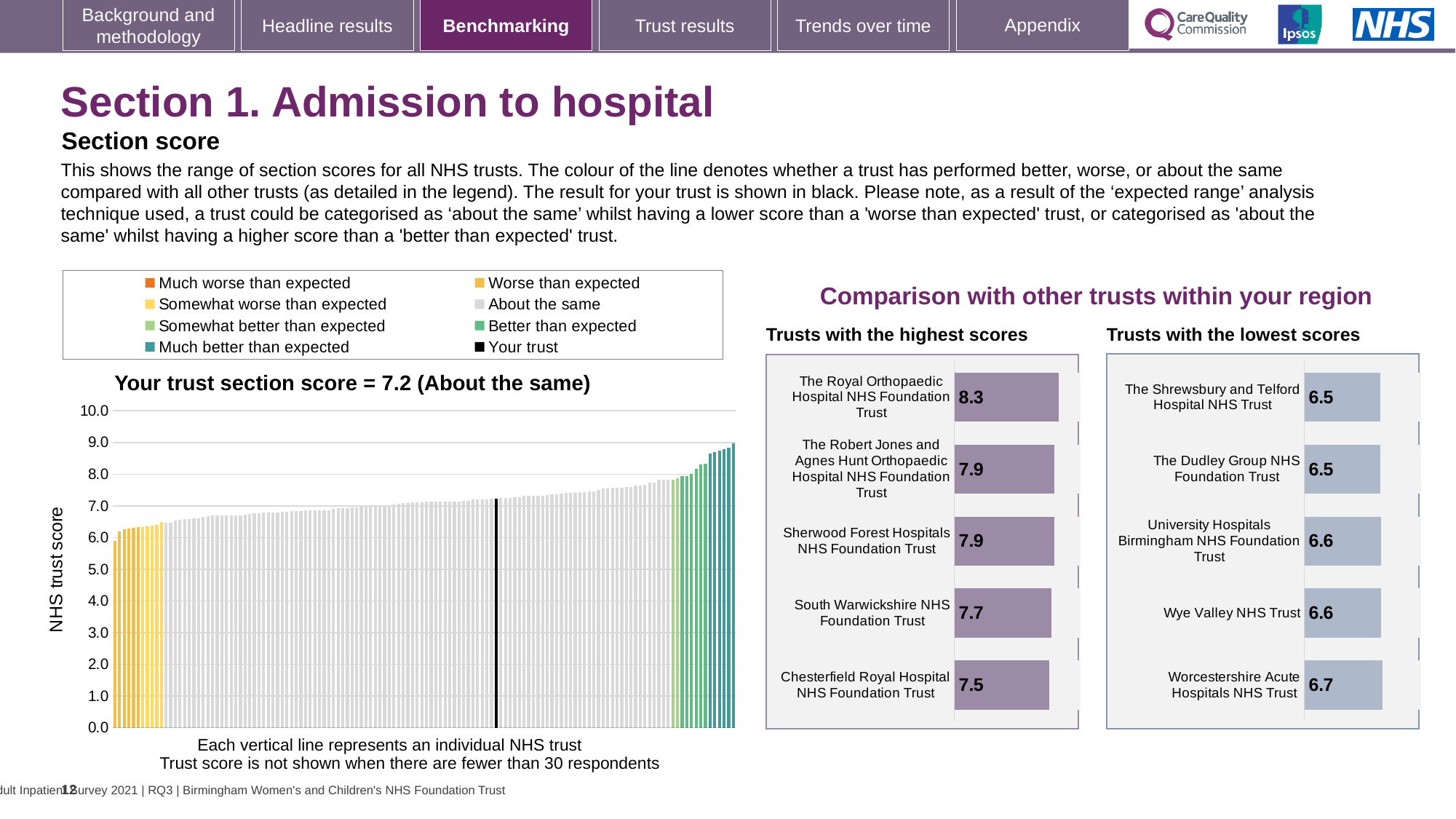
On the 'Trusts with the lowest scores' chart, what is the score for Wye Valley NHS Trust? 6.6 On the 'Your trust section score' chart, is the value of the shortest bar greater or less than 7.0? less How many trusts are shown on the 'Trusts with the lowest scores' chart? 5 How many entries does the legend above the 'Your trust section score' chart list? 8 What is the label on the vertical axis of the 'Your trust section score' chart? NHS trust score On the 'Trusts with the highest scores' chart, what is the difference between the scores of The Royal Orthopaedic Hospital NHS Foundation Trust and Chesterfield Royal Hospital NHS Foundation Trust? 0.8 On the 'Your trust section score' chart, do the bars rise or fall from left to right? rise On the 'Trusts with the highest scores' chart, what is the score for Chesterfield Royal Hospital NHS Foundation Trust? 7.5 On the 'Trusts with the highest scores' chart, which trust has the highest score? The Royal Orthopaedic Hospital NHS Foundation Trust On the 'Your trust section score' chart, is the value of the tallest bar greater or less than 8.0? greater What kind of chart is the 'Your trust section score' chart on the left of the slide? bar chart On the 'Your trust section score' chart, what is the section score for your trust? 7.2